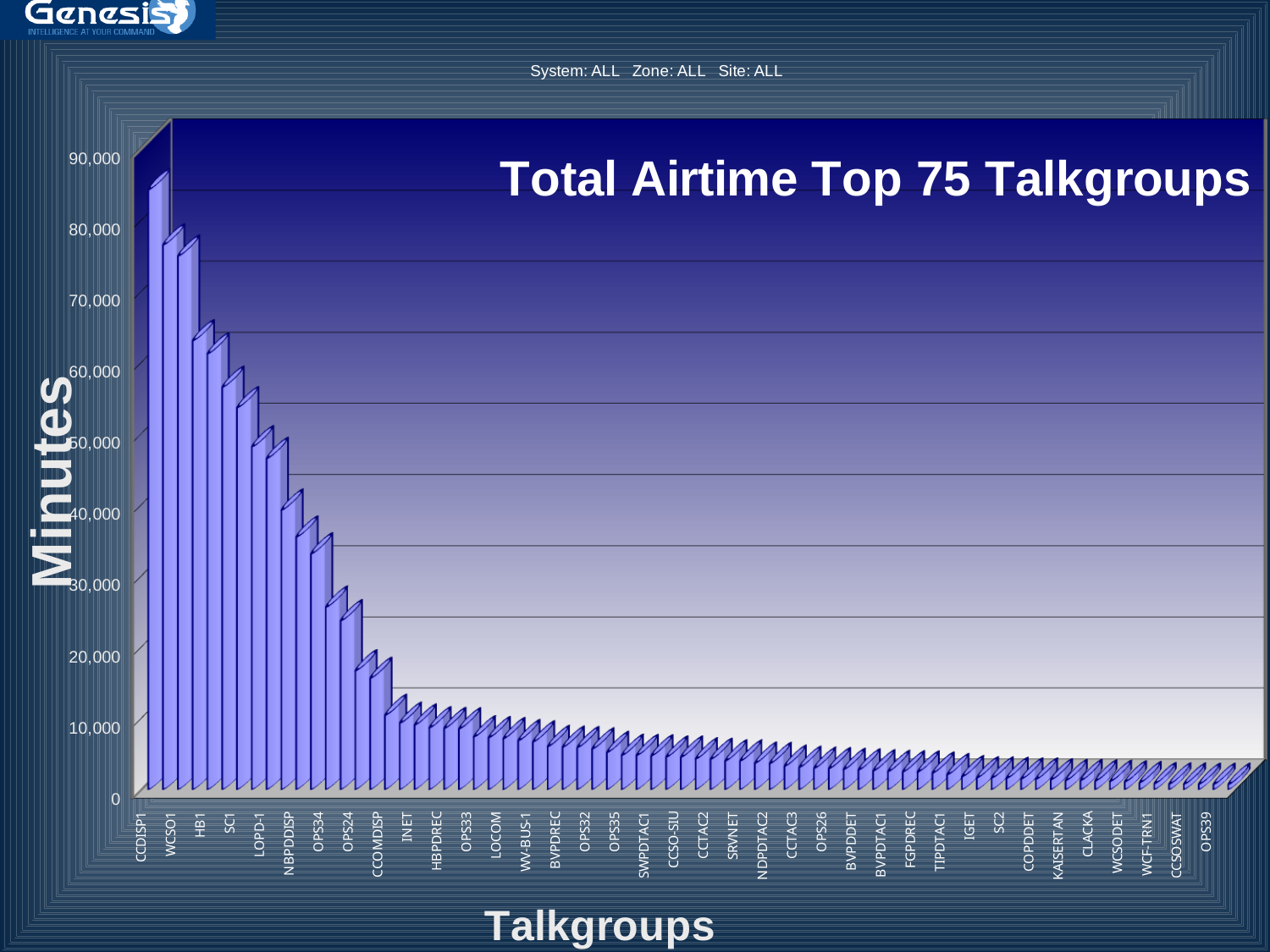
Is the value for WCSO1 greater or less than 70,000? greater Is the value for CCOMDISP greater or less than 20,000? less Which has the larger value, CCDISP1 or WCSO1? CCDISP1 What is the label on the vertical axis of the chart? Minutes What is the title of the chart? Total Airtime Top 75 Talkgroups Which talkgroup has the highest total airtime? CCDISP1 Do the values rise or fall moving from left to right along the x axis? fall Is the value for OPS24 greater or less than 30,000? less Which has the larger value, HB1 or OPS34? HB1 What kind of chart is shown on the slide? bar chart